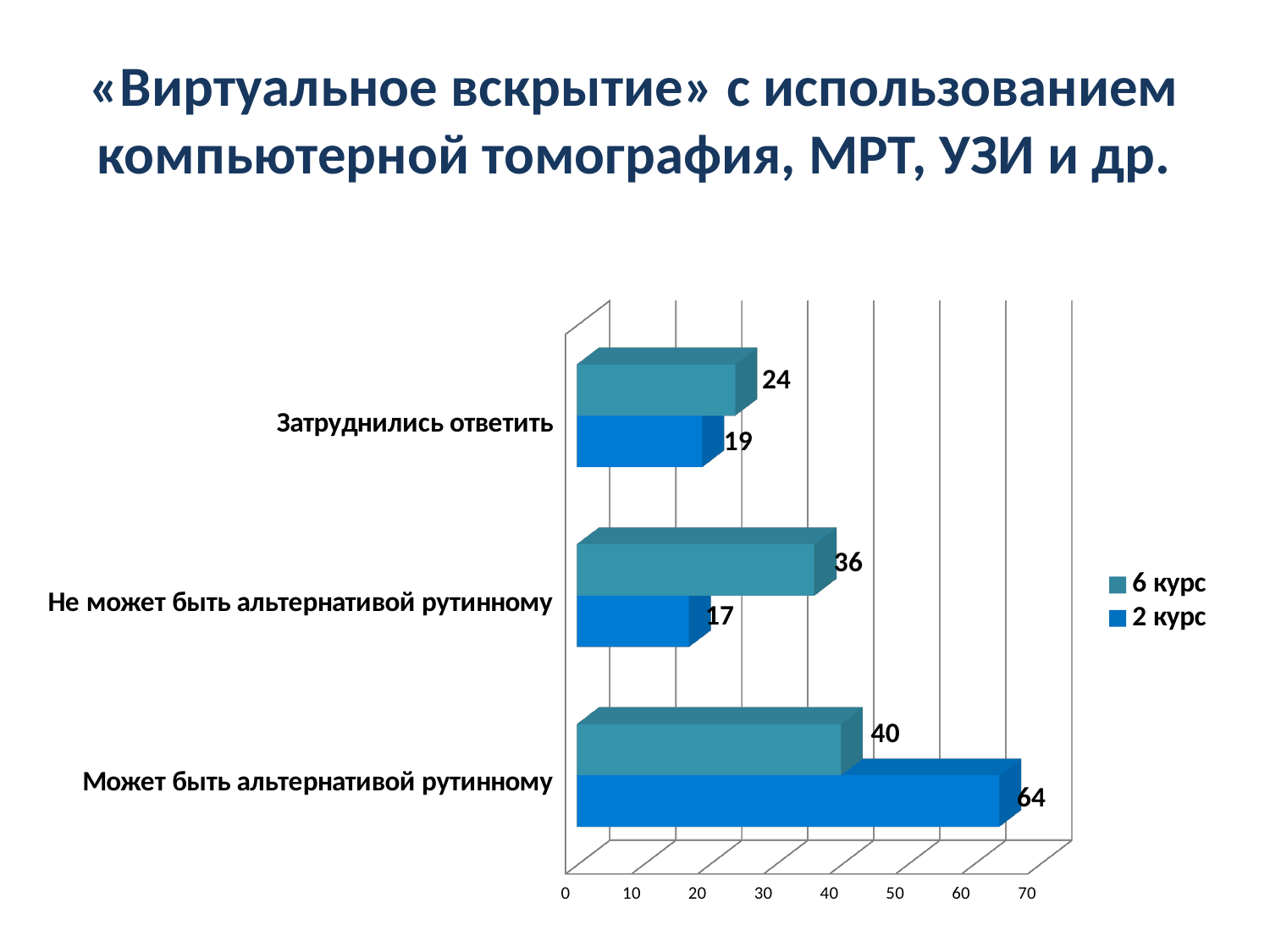
Which category has the highest value for "2 курс"? Может быть альтернативой рутинному What is the value for "6 курс" in the category "Может быть альтернативой рутинному"? 40 What are the two series names listed in the legend? 6 курс and 2 курс In the category "Не может быть альтернативой рутинному", which series has the larger value, "6 курс" or "2 курс"? 6 курс What is the value for "2 курс" in the category "Затруднились ответить"? 19 What is the difference between the "2 курс" and "6 курс" values in the category "Может быть альтернативой рутинному"? 24 How many categories are shown on the chart? 3 What is the value for "6 курс" in the category "Не может быть альтернативой рутинному"? 36 How many series does the legend list? 2 What kind of chart is shown on the slide? Bar chart Which category has the lowest value for "6 курс"? Затруднились ответить What is the value for "2 курс" in the category "Может быть альтернативой рутинному"? 64